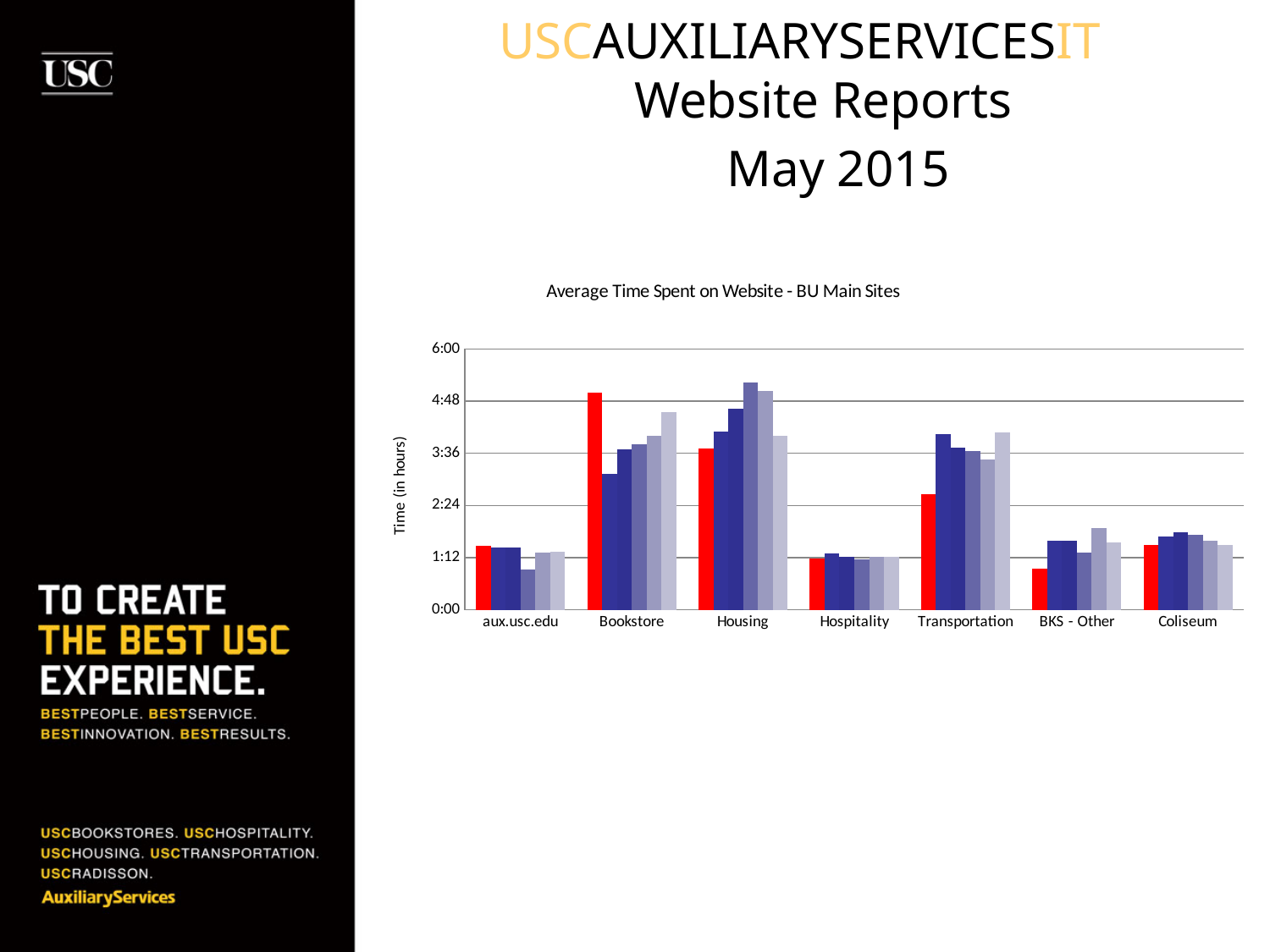
Which is larger, the red bar for Hospitality or the red bar for Transportation? Transportation How many categories are shown along the x axis of the chart? 7 Is the value of the red bar for Coliseum greater or less than 1:12? greater Is the value of the red bar for Bookstore greater or less than 4:48? greater What is the title of the chart? Average Time Spent on Website - BU Main Sites Is the value of the red bar for Transportation greater or less than 2:24? greater What kind of chart is shown on the slide? Bar chart What is the label on the vertical axis of the chart? Time (in hours) Which is larger, the red bar for Bookstore or the red bar for Housing? Bookstore How many bars are plotted for each category in the chart? 6 Which category has the tallest red bar? Bookstore